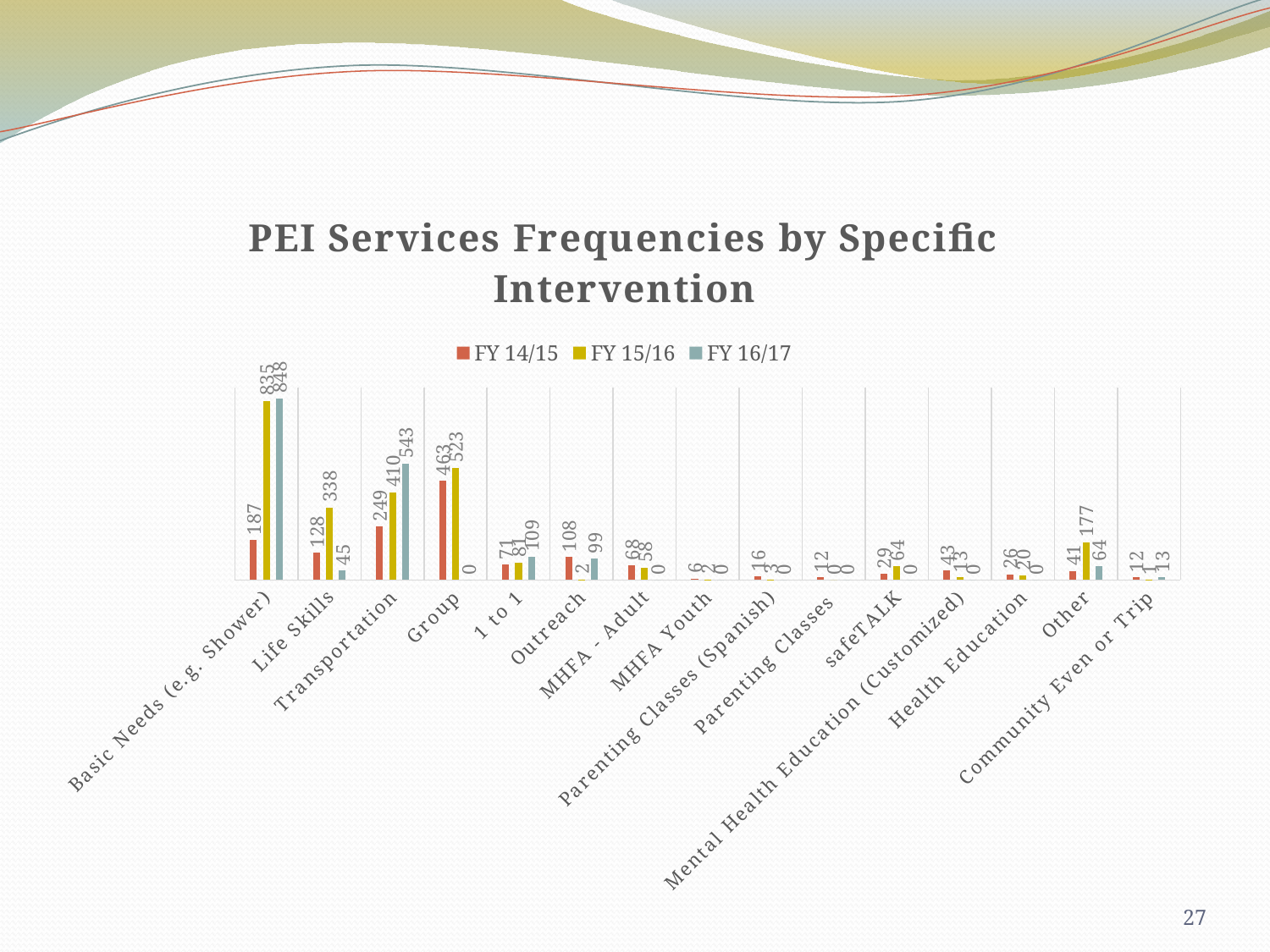
How many series does the legend list? 3 What are the three series named in the legend? FY 14/15, FY 15/16, FY 16/17 Which category has the highest FY 16/17 value? Basic Needs (e.g. Shower) How many intervention categories are shown on the x axis? 15 What kind of chart is shown on the slide? Bar chart What is the difference between the FY 16/17 and FY 14/15 values for Basic Needs (e.g. Shower)? 661 What is the FY 16/17 value for Life Skills? 45 What is the difference between the FY 15/16 and FY 14/15 values for Life Skills? 210 What is the FY 15/16 value for Basic Needs (e.g. Shower)? 835 Which has the larger FY 14/15 value, Group or Transportation? Group What is the FY 16/17 value for Transportation? 543 What is the FY 15/16 value for Other? 177